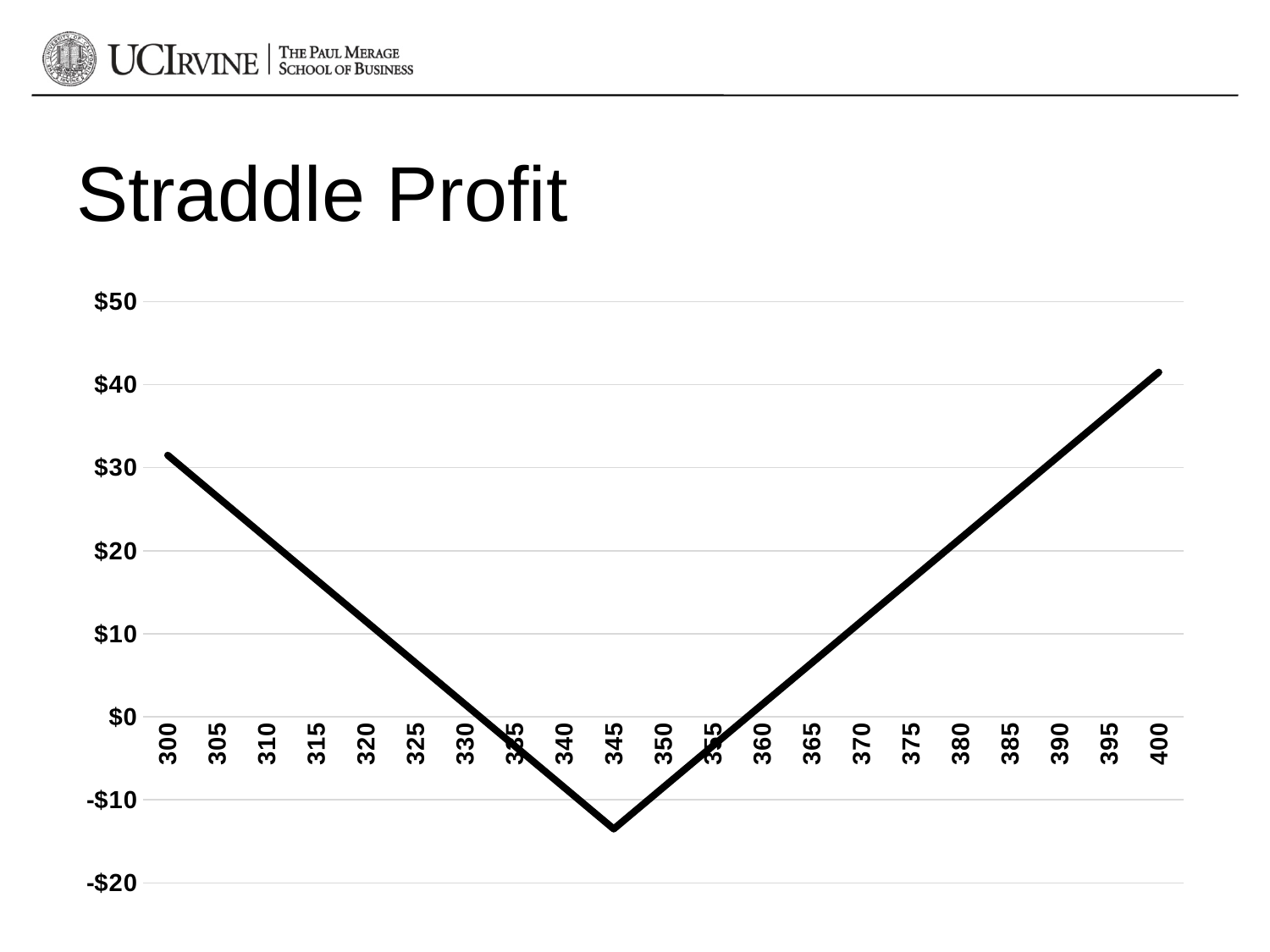
Which has the larger profit, 300 or 400? 400 How does the profit change as the x-axis value moves from 300 to 345? it falls Is the value at 340 greater or less than $0? less Is the value at 300 greater or less than $20? greater At which x-axis value is the profit lowest? 345 Is the value at 385 greater or less than $20? greater What kind of chart is shown on the slide? line chart How many points are plotted along the x axis? 21 At which x-axis value is the profit highest? 400 What is the title of the chart? Straddle Profit